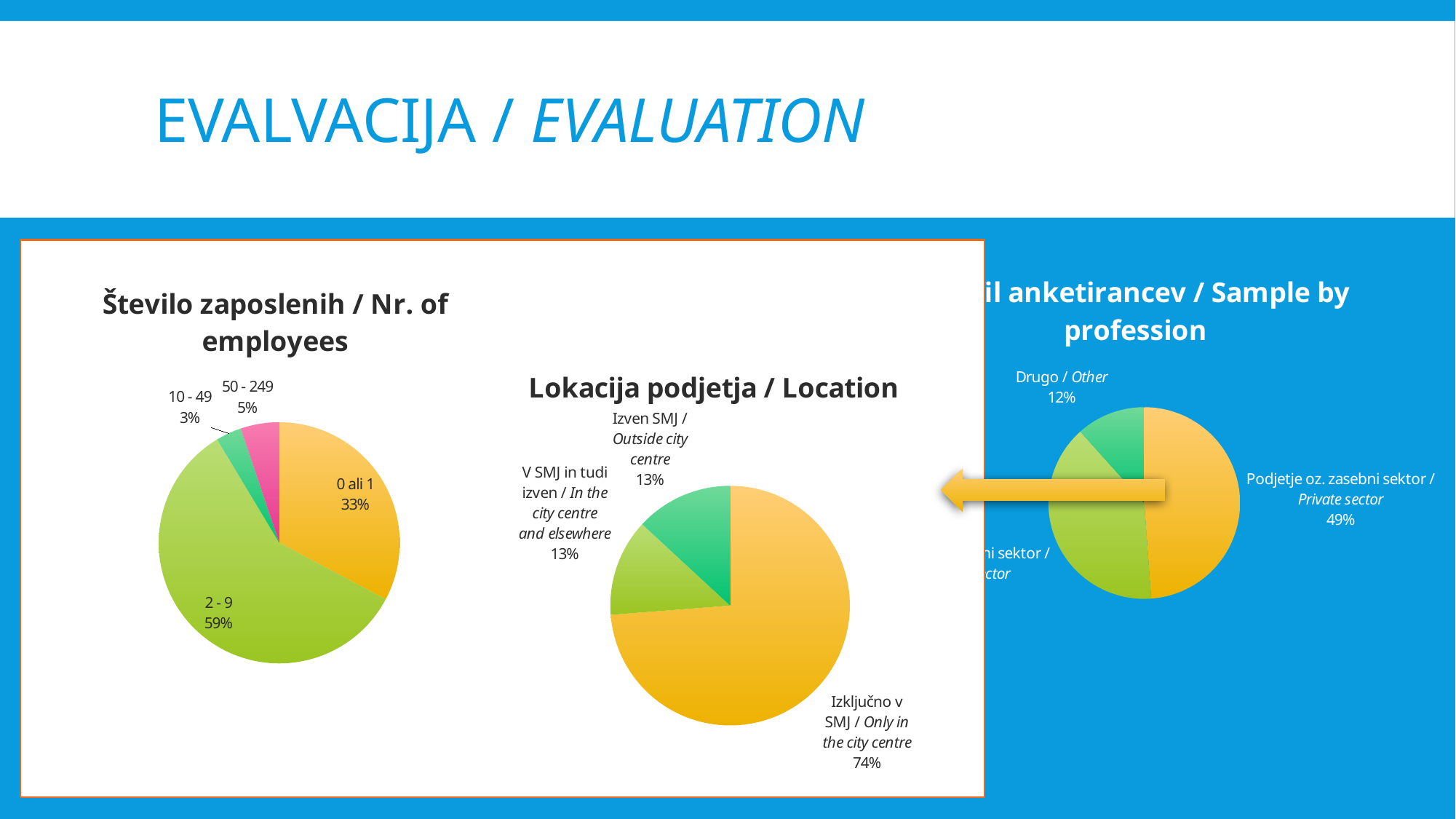
In the 'Nr. of employees' chart, how many categories are shown? 4 In the 'Nr. of employees' chart, what share of respondents have 0 ali 1 employees? 33% What type of chart is the 'Location' chart? Pie chart In the 'Location' chart, what share of companies are located outside the city centre? 13% In the 'Nr. of employees' chart, which category has the smallest share? 10 - 49 In the 'Location' chart, how many slices does the pie have? 3 In the 'Nr. of employees' chart, which category has the largest share? 2 - 9 In the 'Location' chart, what share of companies are located only in the city centre? 74% In the 'Sample by profession' chart, which is larger: the 'Drugo / Other' slice or the 'Private sector' slice? Private sector In the 'Sample by profession' chart, what share of respondents are from the private sector? 49% In the 'Nr. of employees' chart, what is the difference in percentage points between the 2 - 9 and 0 ali 1 slices? 26 In the 'Nr. of employees' chart, what share of respondents have 2 - 9 employees? 59%